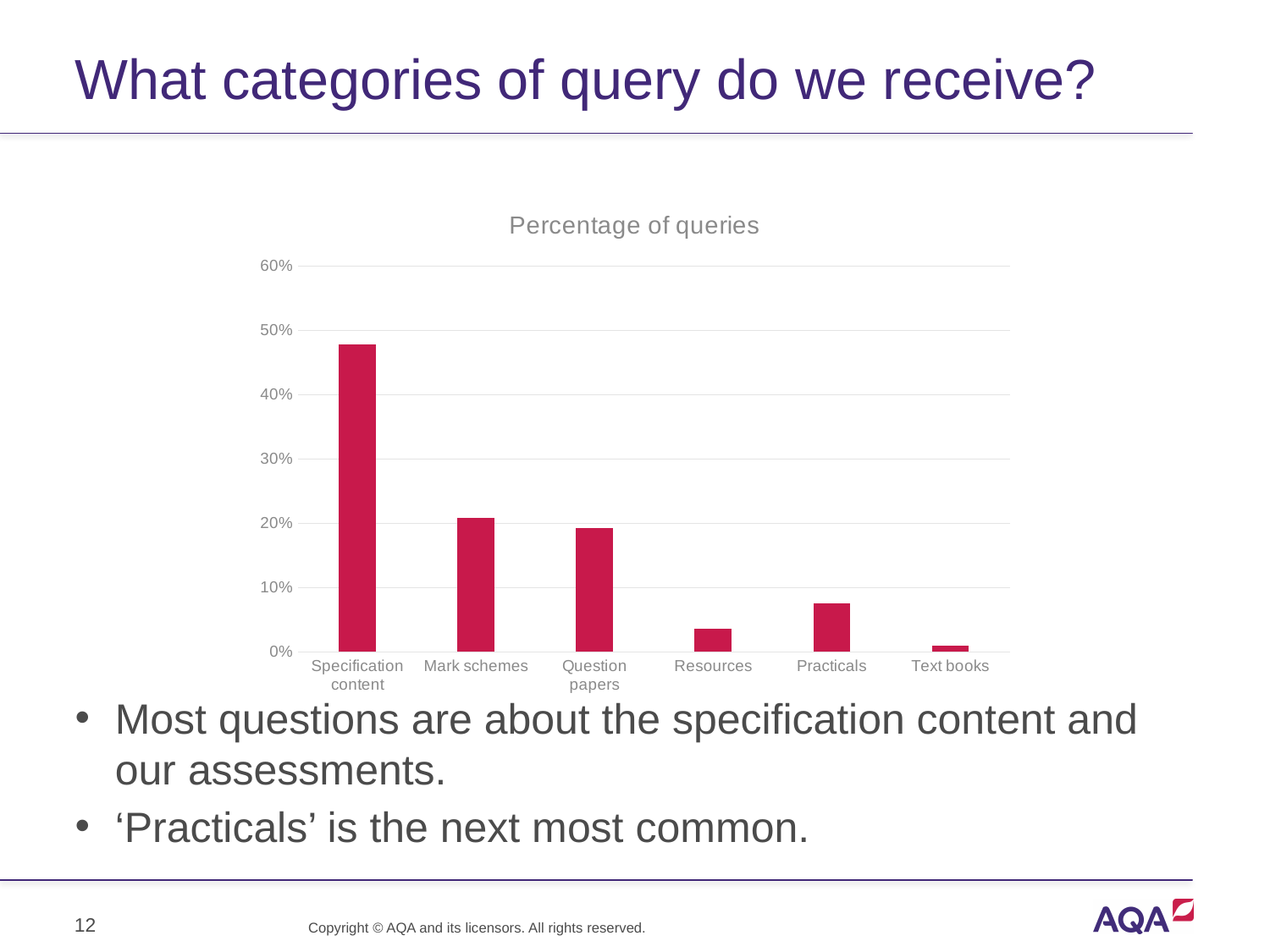
What is the title of the chart? Percentage of queries Is the value for Practicals greater or less than 10%? less Which category has the highest percentage of queries? Specification content Is the value for Specification content greater or less than 50%? less Which has a larger percentage of queries, Practicals or Resources? Practicals Which has a larger percentage of queries, Specification content or Mark schemes? Specification content Which category has the lowest percentage of queries? Text books How many categories are shown on the x axis of the chart? 6 What type of chart is shown on the slide? bar chart Is the value for Specification content greater or less than 40%? greater